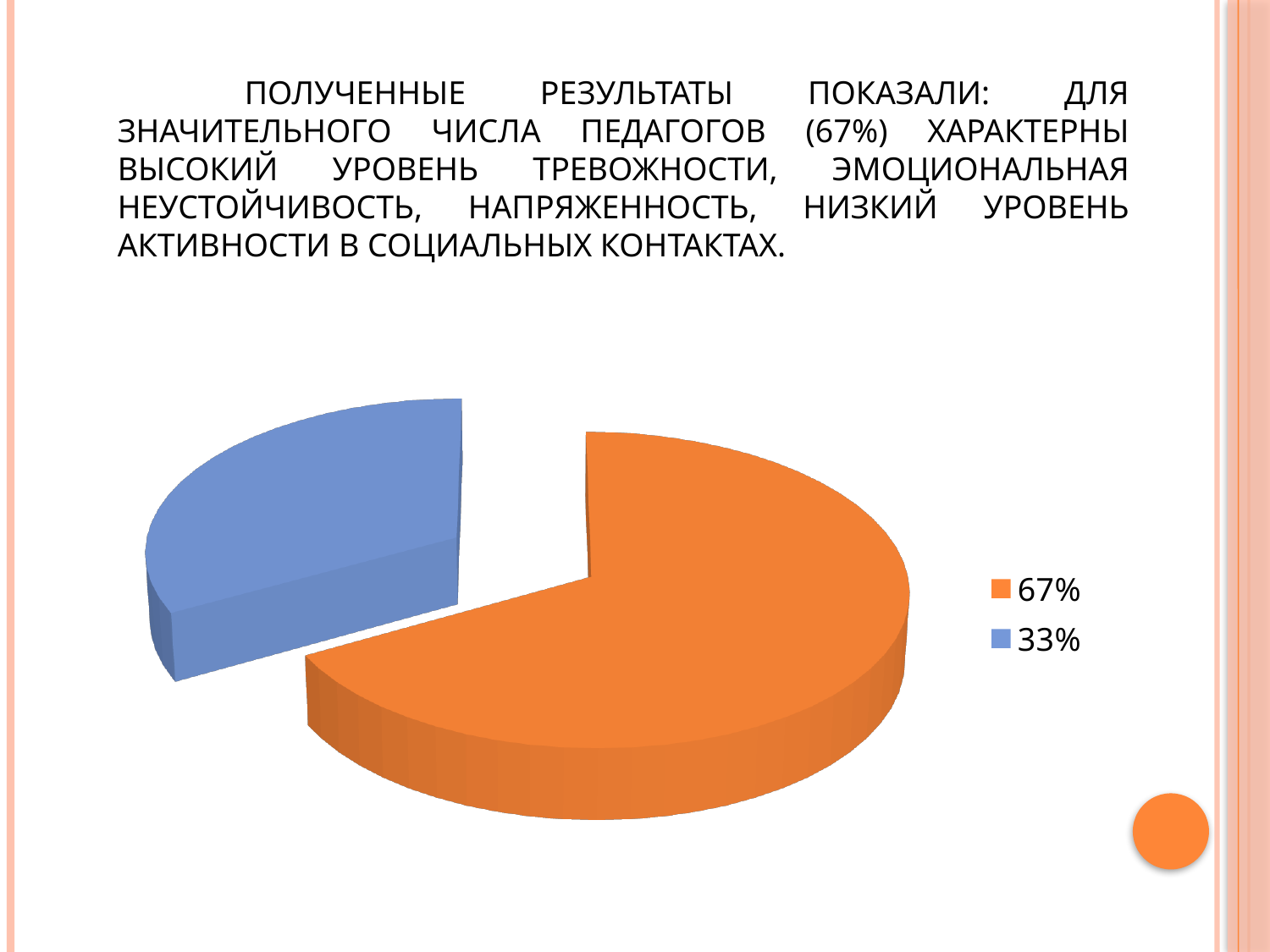
What is the difference between the orange slice's share and the blue slice's share? 34% How many slices does the pie chart have? 2 What colour is the slice labelled 67% in the legend? orange What share of the pie does the orange slice represent? 67% Which slice of the pie chart is the largest? the orange slice (67%) Is the share of the blue slice greater or less than 50%? less What colour is the slice labelled 33% in the legend? blue Which is larger, the orange slice or the blue slice? the orange slice What kind of chart is shown on the slide? pie chart What share of the pie does the blue slice represent? 33% Which slice of the pie chart is the smallest? the blue slice (33%) How many entries does the legend of the pie chart list? 2